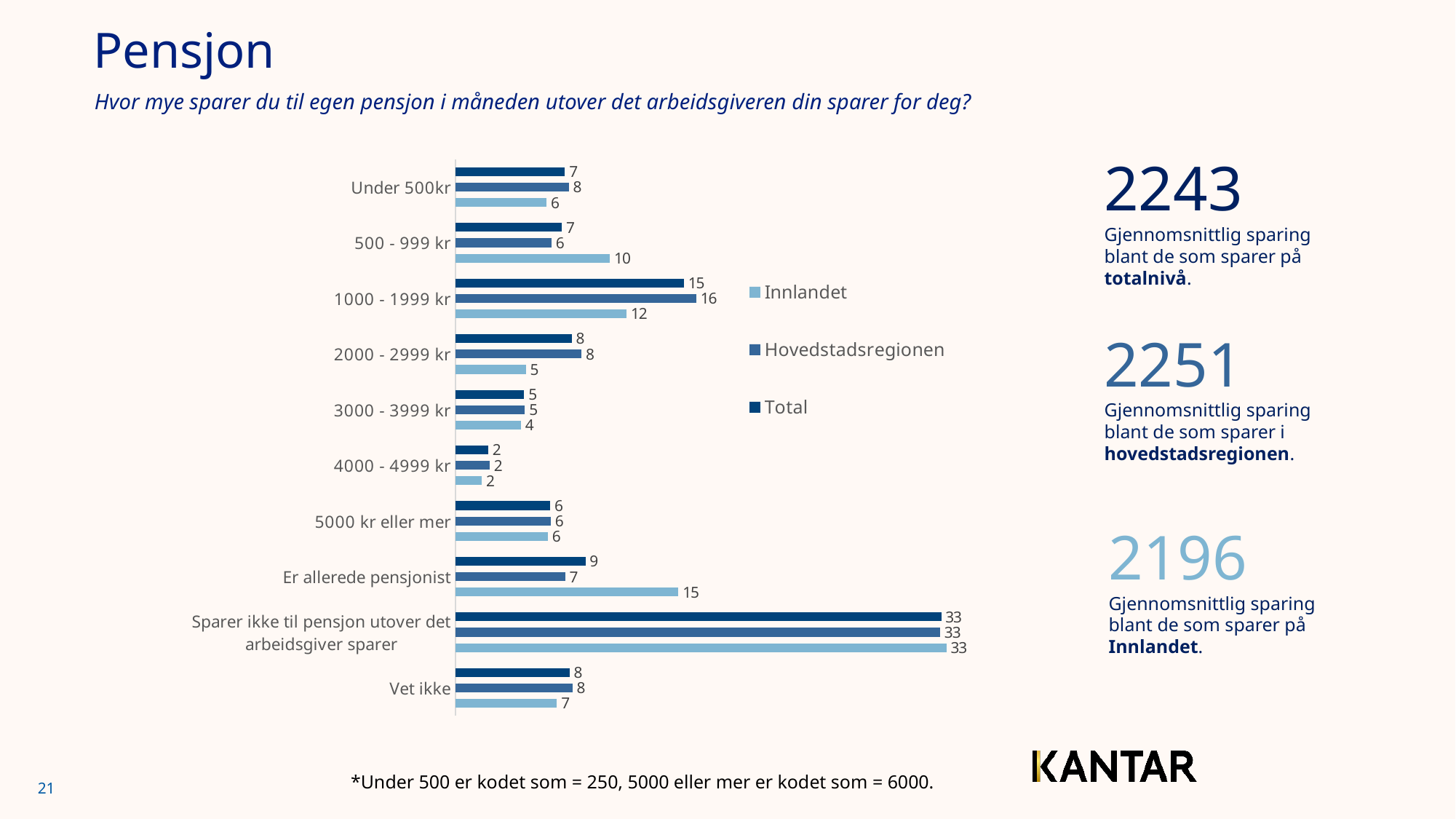
What is the Total value for 'Er allerede pensjonist'? 9 Which category has the lowest Innlandet value? 4000 - 4999 kr What is the Hovedstadsregionen value for '1000 - 1999 kr'? 16 What is the Innlandet value for 'Vet ikke'? 7 For '2000 - 2999 kr', which is larger: the Total value or the Innlandet value? Total Which series is shown in the lightest blue colour in the legend? Innlandet How many series does the legend list? 3 What type of chart is shown on the slide? bar chart What is the difference between the Innlandet and Hovedstadsregionen values for 'Er allerede pensjonist'? 8 Which category has the highest Total value? Sparer ikke til pensjon utover det arbeidsgiver sparer How many categories are shown on the chart? 10 What is the Innlandet value for '500 - 999 kr'? 10